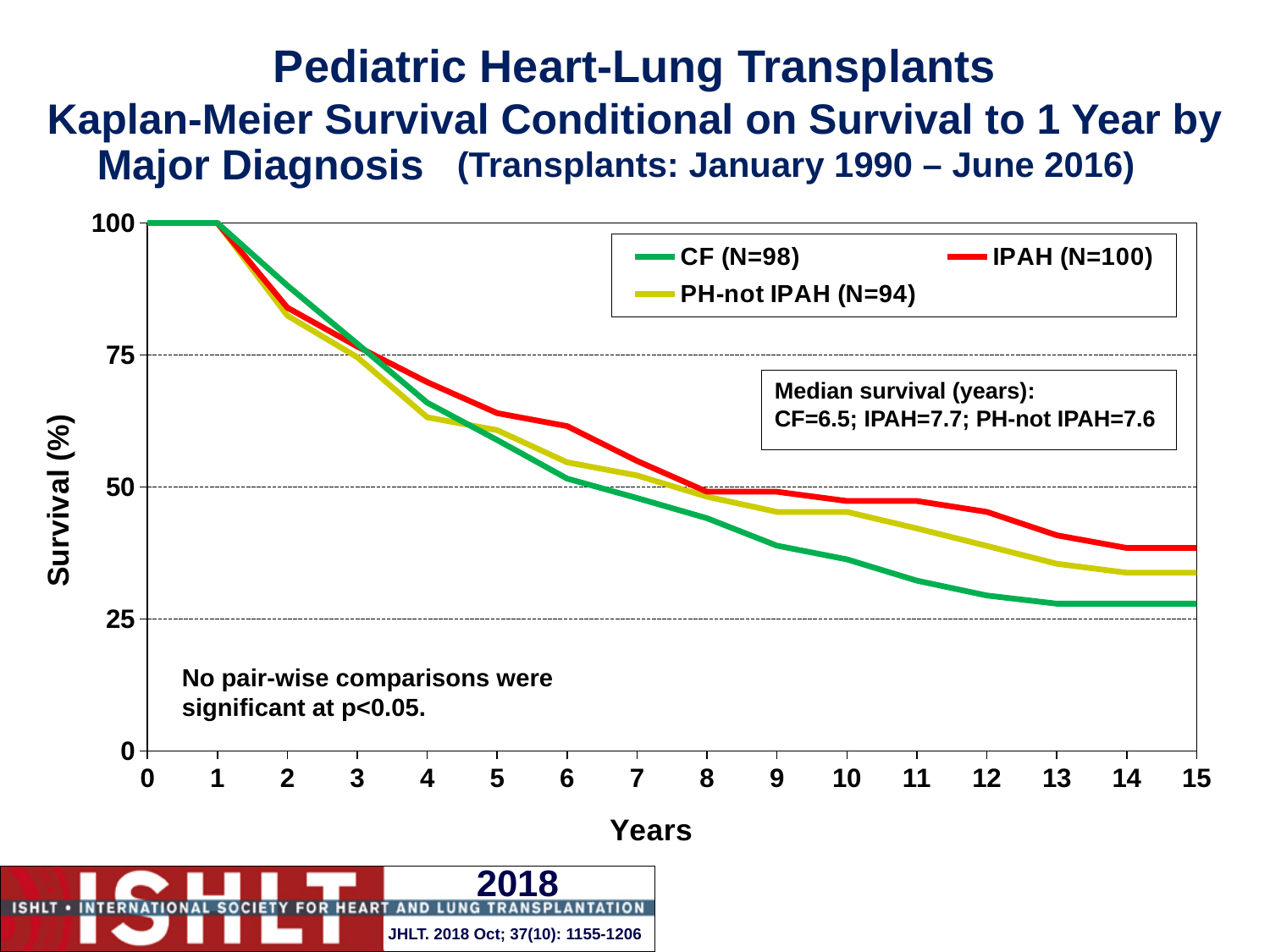
What is the N for the PH-not IPAH group shown in the legend? 94 Do the survival curves rise or fall as years increase? fall What is the median survival in years for the CF group, as stated on the slide? 6.5 At 10 years, which group has higher survival, PH-not IPAH or CF? PH-not IPAH Which diagnosis group has the lowest survival at 15 years? CF Is the survival value for IPAH at 15 years greater or less than 25? greater Is the survival value for CF at 15 years greater or less than 50? less How many series does the legend list? 3 What is the median survival in years for the PH-not IPAH group, as stated on the slide? 7.6 What kind of chart is shown on the slide? line chart What is the median survival in years for the IPAH group, as stated on the slide? 7.7 Which diagnosis group has the highest survival at 15 years? IPAH